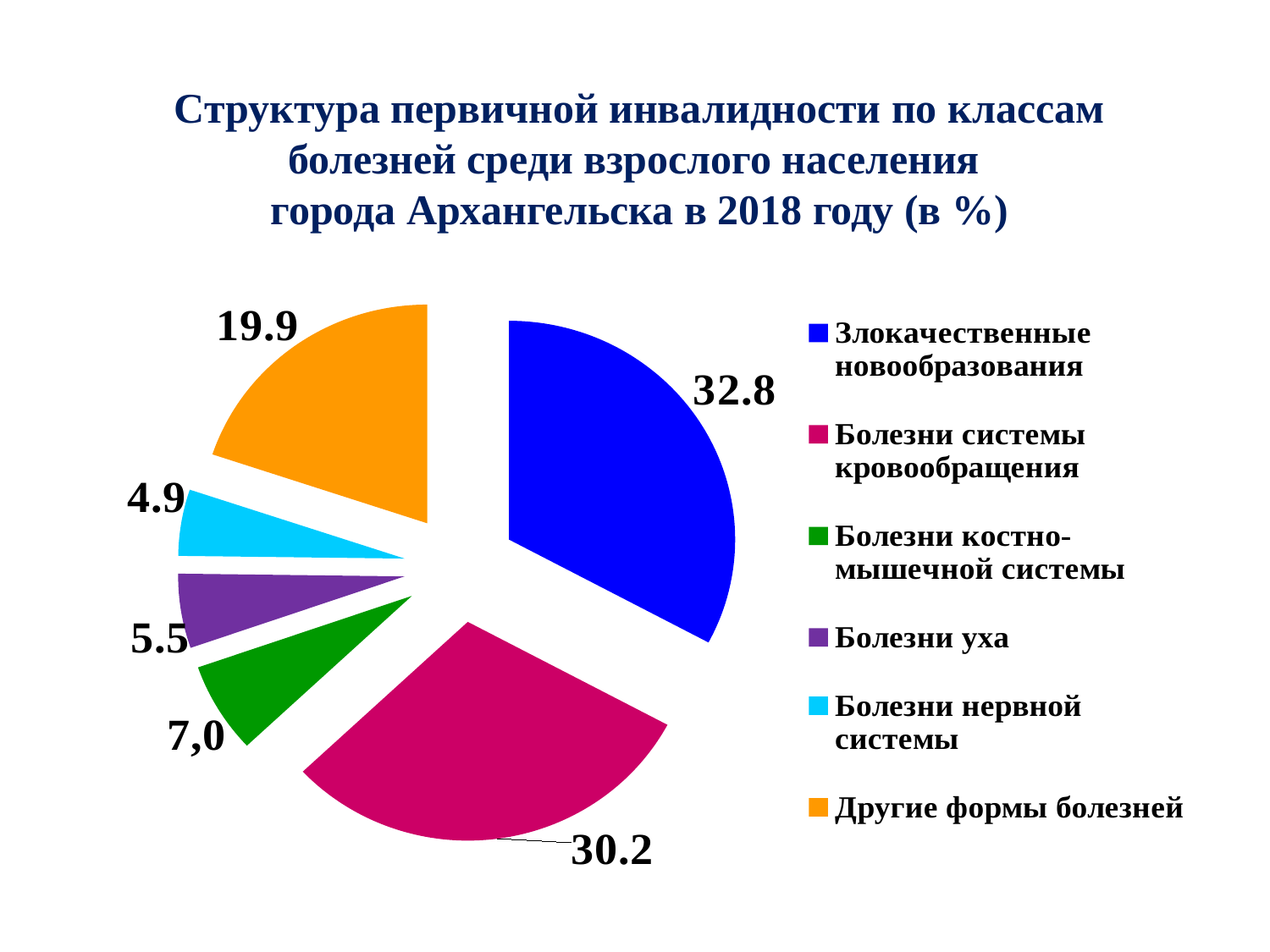
What type of chart is shown on the slide? Pie chart What value is shown for Болезни системы кровообращения? 30.2 How many slices does the pie chart have? 6 Which category has the largest slice of the pie? Злокачественные новообразования What value is shown for Болезни уха? 5.5 What share of the pie does Злокачественные новообразования account for? 32.8 What value is shown for Болезни костно-мышечной системы? 7,0 Which category has the smallest slice of the pie? Болезни нервной системы What is the difference between the values for Злокачественные новообразования and Болезни системы кровообращения? 2.6 What value is shown for Болезни нервной системы? 4.9 Which is larger: the value for Другие формы болезней or the value for Болезни уха? Другие формы болезней What value is shown for Другие формы болезней? 19.9